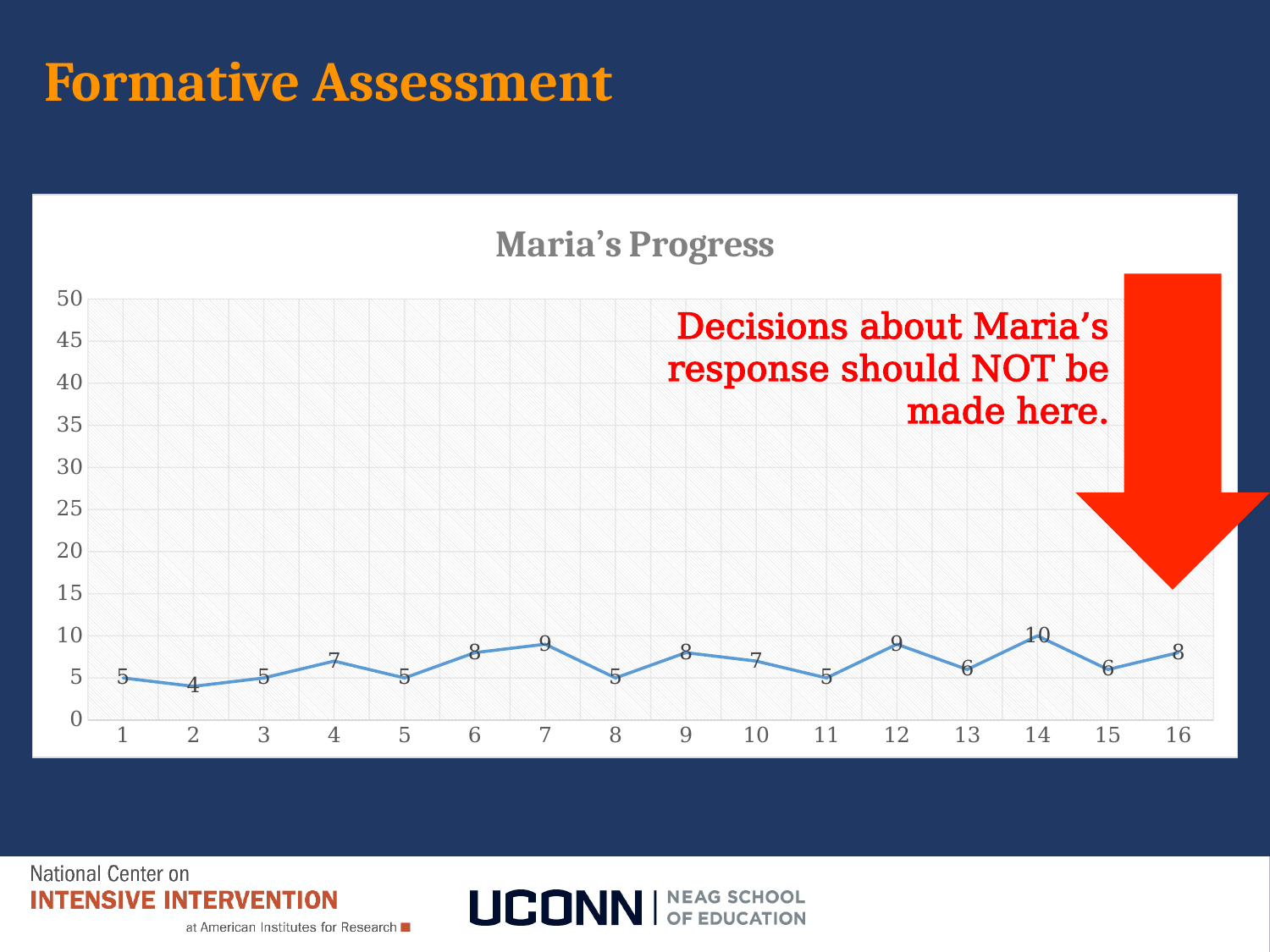
At which x-axis point is the value lowest? 2 What is the title of the chart? Maria's Progress What is the difference between the values at point 14 and point 2? 6 Is the value at point 16 greater or less than 10? less Which has the larger value, point 4 or point 5? point 4 What is the value at point 2? 4 At which x-axis point is the value highest? 14 What is the value at point 14? 10 What kind of chart is shown on the slide? line chart What is the highest value shown on the y axis? 50 How many data points are plotted on the line? 16 What is the value at point 7? 9